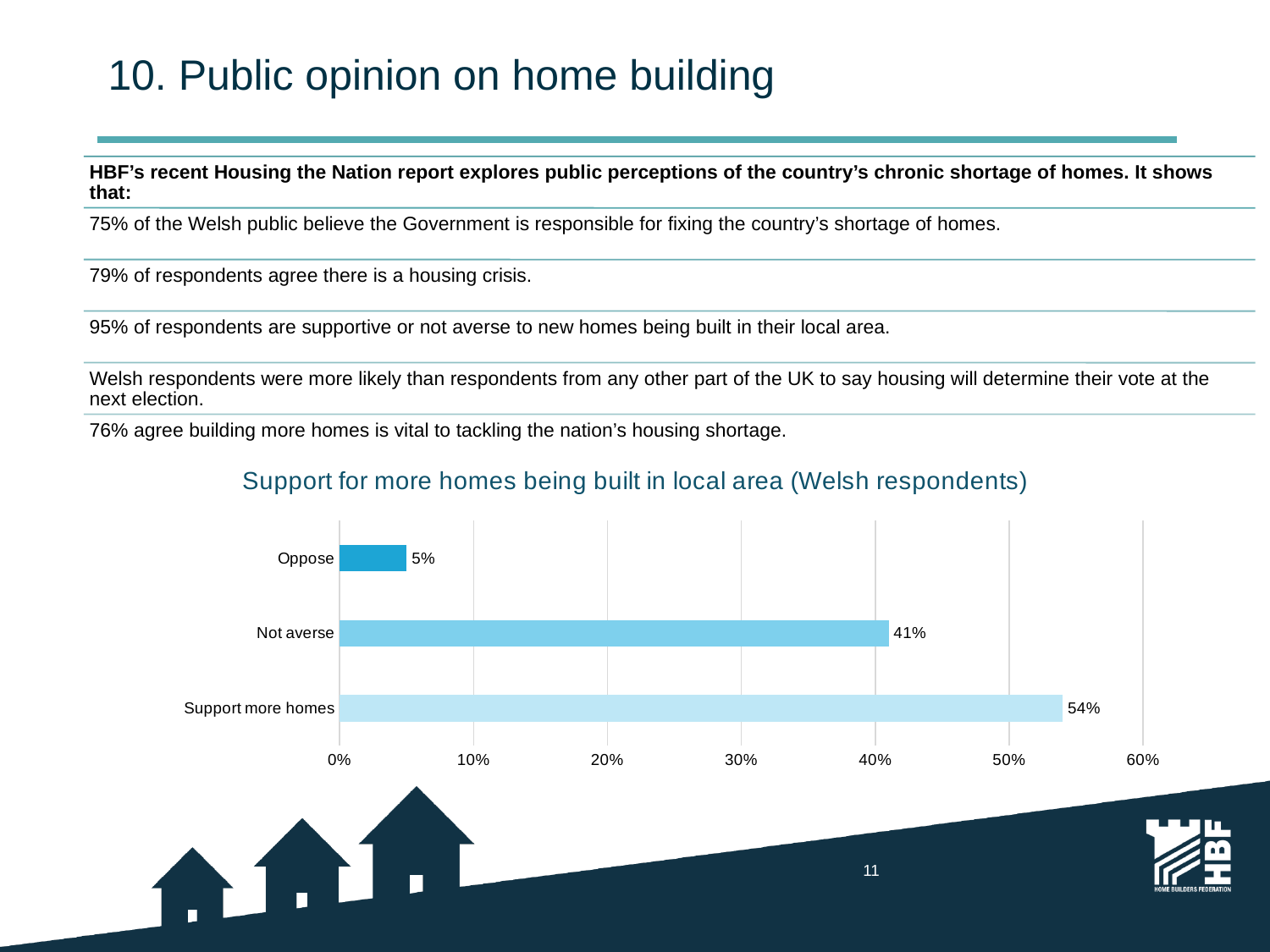
What is the difference between the 'Support more homes' and 'Not averse' values? 13% What is the value for 'Not averse' in the chart? 41% Which category has the highest value in the chart? Support more homes What percentage of respondents support more homes? 54% Is the value for 'Support more homes' greater or less than 50%? greater What is the title of the chart? Support for more homes being built in local area (Welsh respondents) Which is larger, the value for 'Not averse' or the value for 'Oppose'? Not averse How many categories are shown in the chart? 3 What type of chart is shown on the slide? Bar chart What is the difference between the 'Not averse' and 'Oppose' values? 36% What percentage of Welsh respondents oppose more homes being built in their local area? 5% Which category has the lowest value in the chart? Oppose